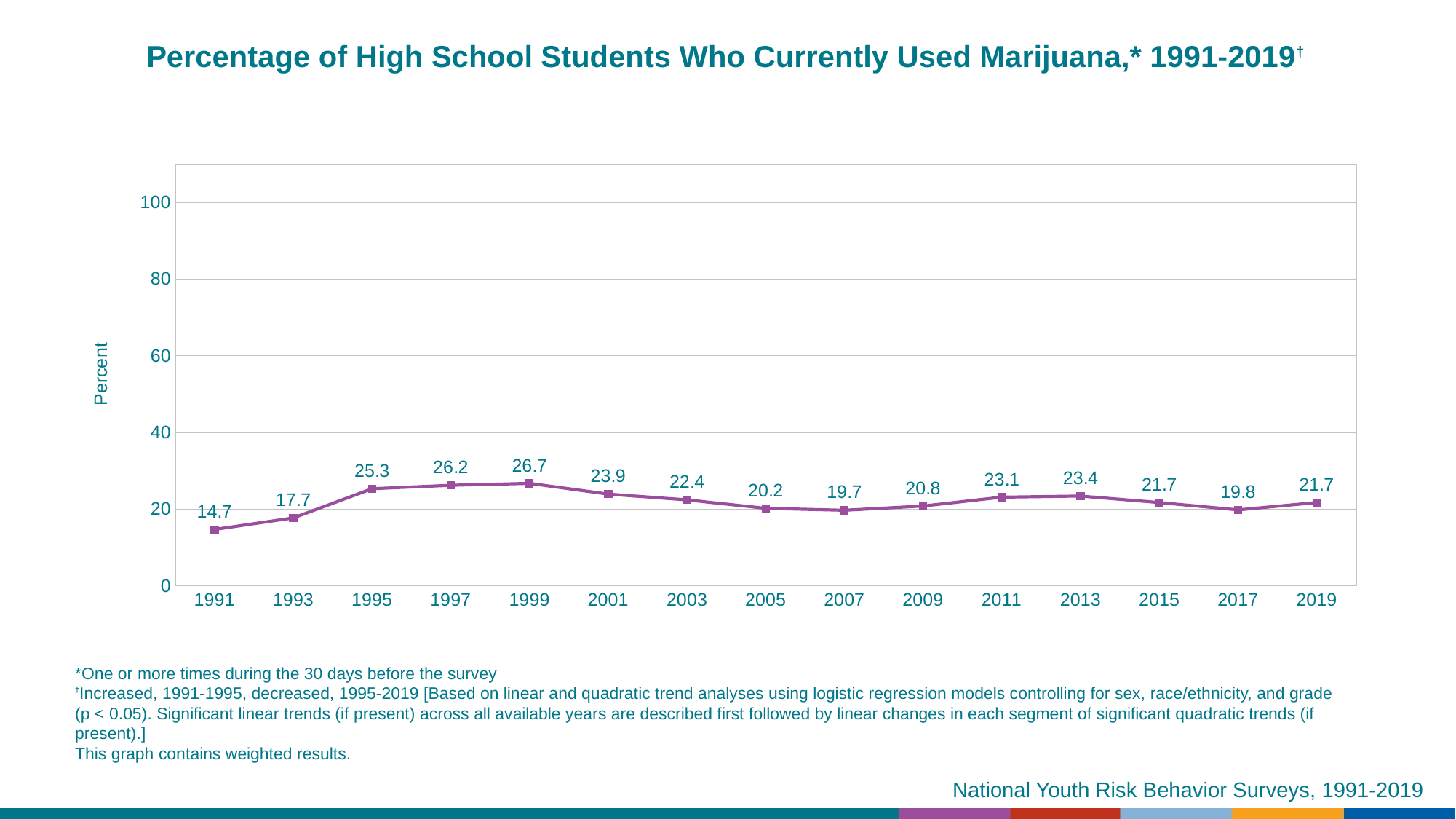
What was the percentage of high school students who currently used marijuana in 2019? 21.7 Is the value for 1995 greater or less than 20? greater Which year had a higher percentage, 2013 or 2017? 2013 What was the percentage of high school students who currently used marijuana in 1991? 14.7 Did the percentage rise or fall from 1991 to 1995? Rise In which year was the percentage of high school students who currently used marijuana highest? 1999 What is the label on the y axis of the chart? Percent What was the percentage of high school students who currently used marijuana in 2007? 19.7 What kind of chart is shown on the slide? Line chart In which year was the percentage of high school students who currently used marijuana lowest? 1991 What is the difference between the percentage in 1999 and the percentage in 1991? 12 How many survey years are plotted on the chart? 15